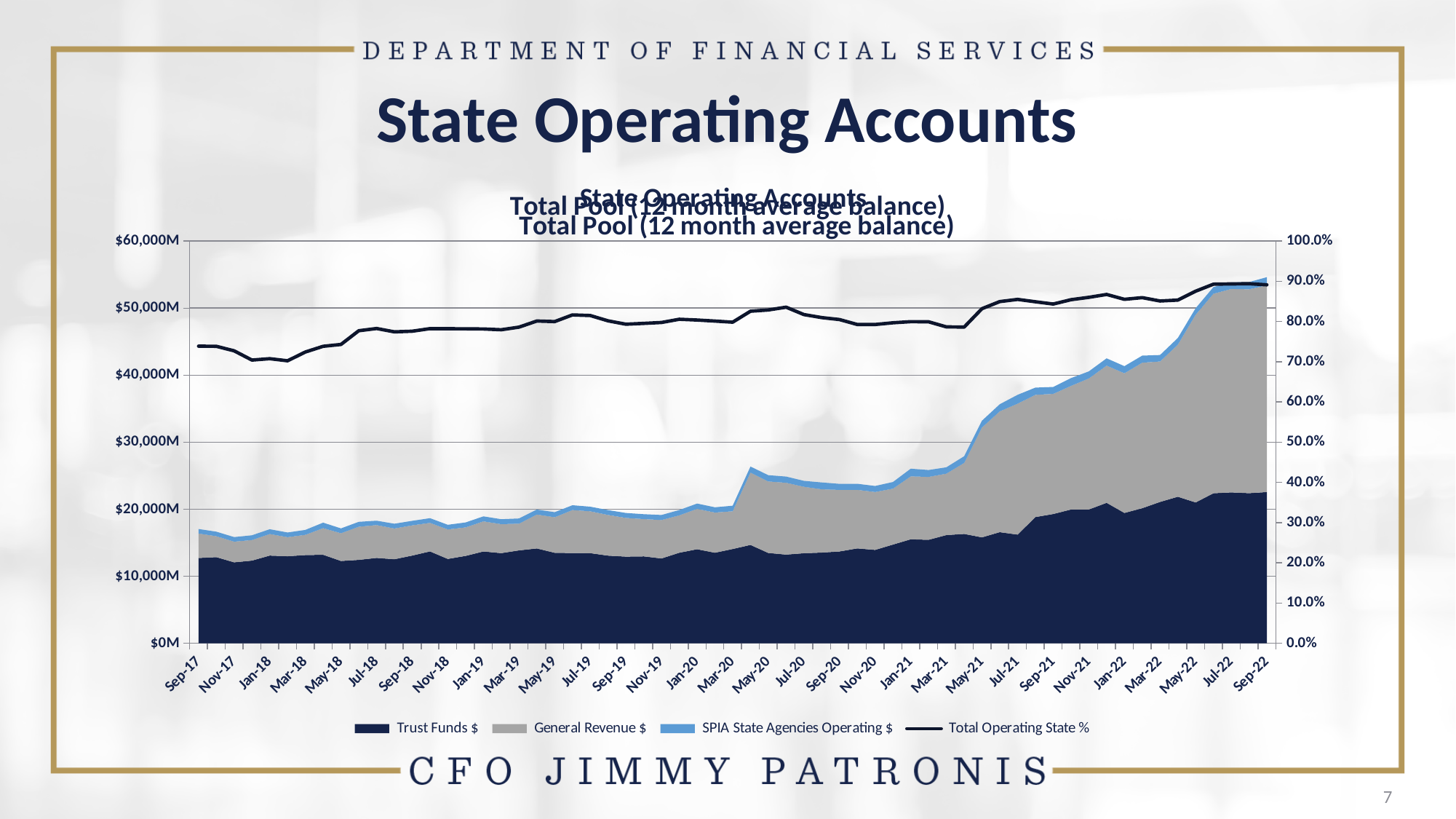
Is the Total Operating State % at Sep-17 greater or less than 80.0%? less What is the first month label on the x axis? Sep-17 Which series is plotted as a line against the right-hand percentage axis? Total Operating State % Which series is shown in grey in the stacked area? General Revenue $ Is the total stacked balance at Sep-17 greater or less than $20,000M? less How many series does the legend list? 4 Does the total stacked balance rise or fall overall from Sep-17 to Sep-22? rise Is the Total Operating State % at Sep-22 greater or less than 80.0%? greater Is the total stacked balance larger at Sep-17 or at Sep-22? Sep-22 What kind of chart is shown on the slide? stacked area chart with a line